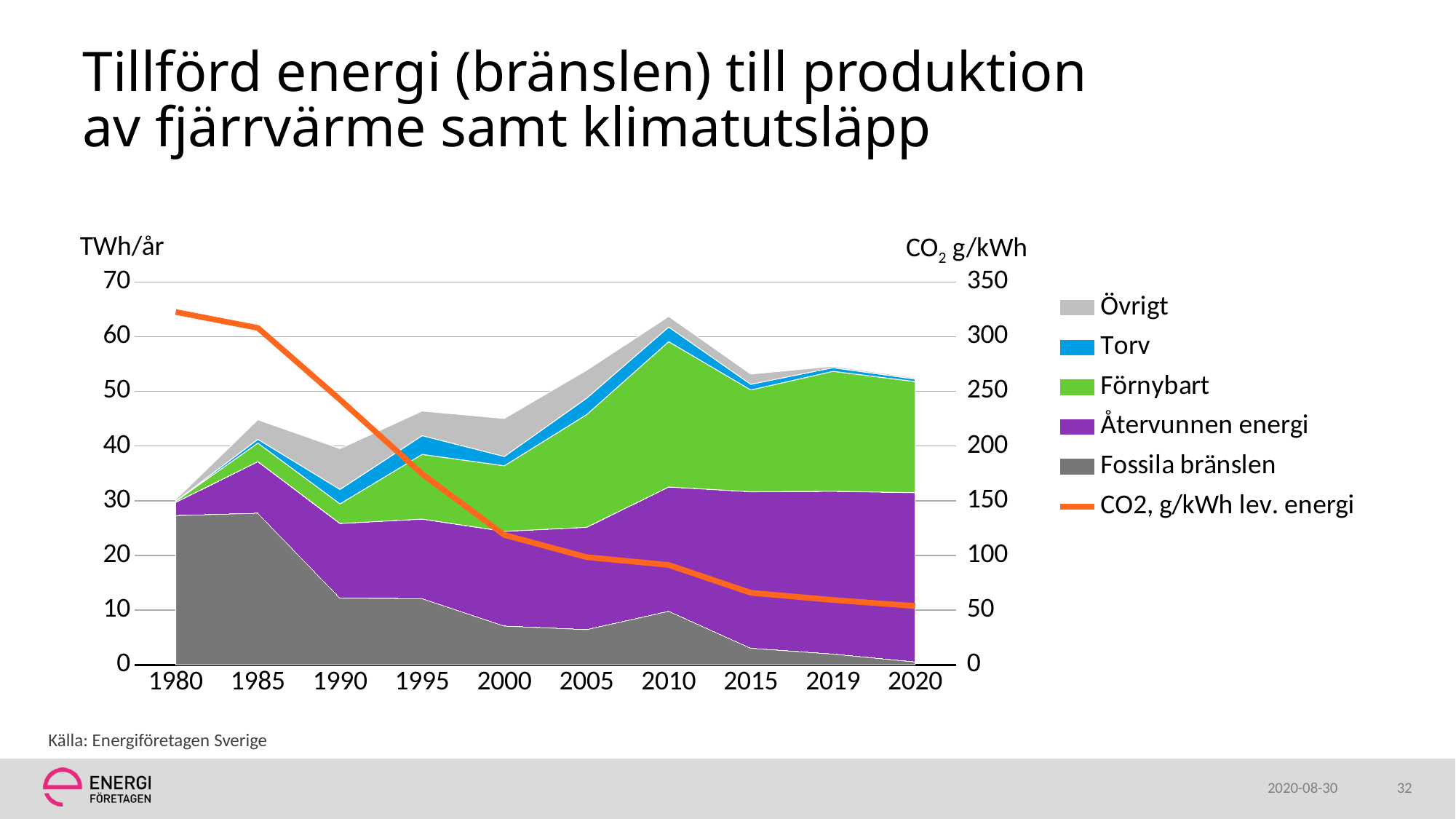
What kind of chart is shown on the slide? stacked area chart with a line Is the value for Fossila bränslen larger in 1980 or in 2020? 1980 Does the CO2, g/kWh lev. energi line rise or fall from 1980 to 2020? fall In which year is the CO2, g/kWh lev. energi value lowest? 2020 Is the value for Fossila bränslen in 1980 greater or less than 20 TWh/år? greater Is the CO2, g/kWh lev. energi value for 2020 greater or less than 100? less In which year is the CO2, g/kWh lev. energi value highest? 1980 Which series is shown in green? Förnybart How many series does the legend list? 6 Is the value for Fossila bränslen in 2020 greater or less than 10 TWh/år? less How many years are shown on the x axis? 10